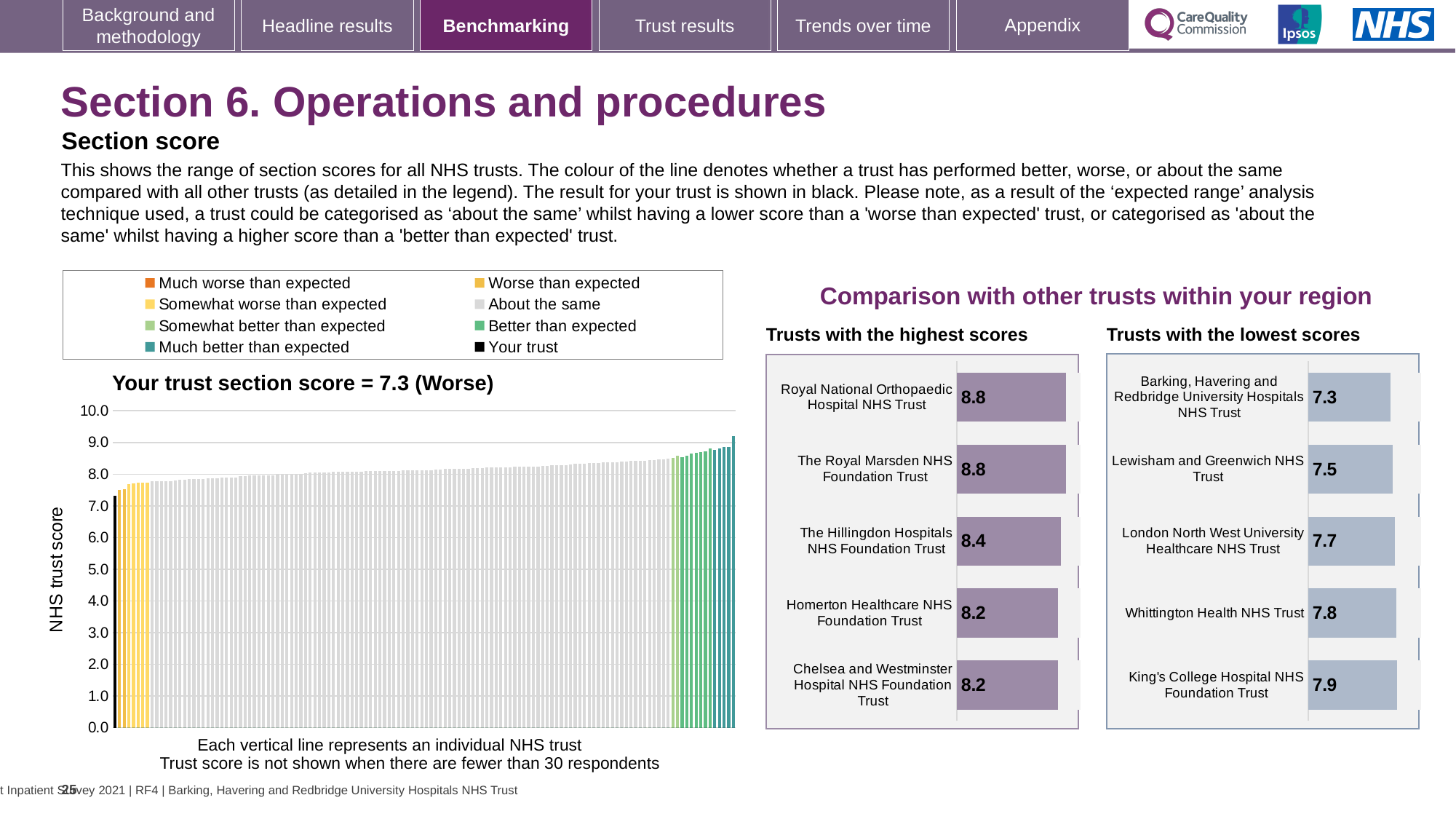
In the 'Trusts with the lowest scores' chart, what is the score for Whittington Health NHS Trust? 7.8 In the 'Trusts with the lowest scores' chart, which is larger: the score for Lewisham and Greenwich NHS Trust or King's College Hospital NHS Foundation Trust? King's College Hospital NHS Foundation Trust What is the y-axis label of the 'Your trust section score' chart? NHS trust score How many entries does the legend above the 'Your trust section score' chart list? 8 What kind of chart is the 'Your trust section score = 7.3 (Worse)' chart? bar chart In the 'Your trust section score' chart, what is the section score for your trust? 7.3 In the 'Trusts with the lowest scores' chart, which trust has the lowest score? Barking, Havering and Redbridge University Hospitals NHS Trust In the 'Trusts with the highest scores' chart, what is the difference between Royal National Orthopaedic Hospital NHS Trust and The Hillingdon Hospitals NHS Foundation Trust? 0.4 In the 'Your trust section score' chart, is the value of the lowest bar greater or less than 8.0? less How many trusts are shown in the 'Trusts with the highest scores' chart? 5 In the 'Trusts with the highest scores' chart, what is the score for The Hillingdon Hospitals NHS Foundation Trust? 8.4 In the 'Your trust section score' chart, do the bars rise or fall from left to right? rise